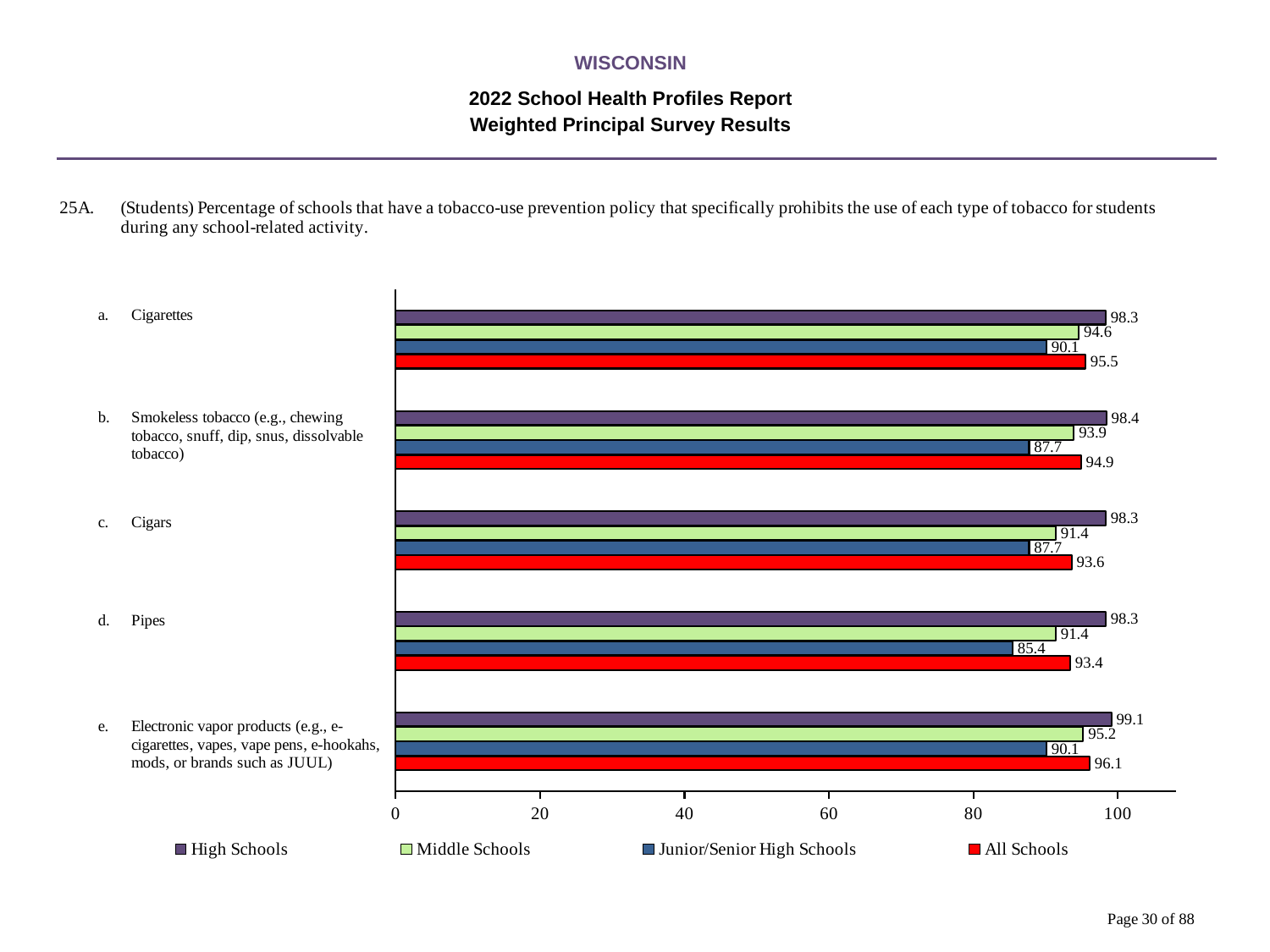
What is the value for All Schools for Electronic vapor products? 96.1 Which series is shown in red in the legend? All Schools What is the difference between the High Schools and Junior/Senior High Schools values for Cigars? 10.6 How many series does the legend list? 4 What is the value for Middle Schools for Smokeless tobacco? 93.9 Which category has the lowest value for Junior/Senior High Schools? Pipes What is the value for Junior/Senior High Schools for Pipes? 85.4 How many categories are shown on the chart? 5 Which is larger for Cigarettes: the Middle Schools value or the All Schools value? All Schools What is the value for High Schools for Cigarettes? 98.3 What kind of chart is shown on the slide? Bar chart Which category has the highest value for High Schools? Electronic vapor products